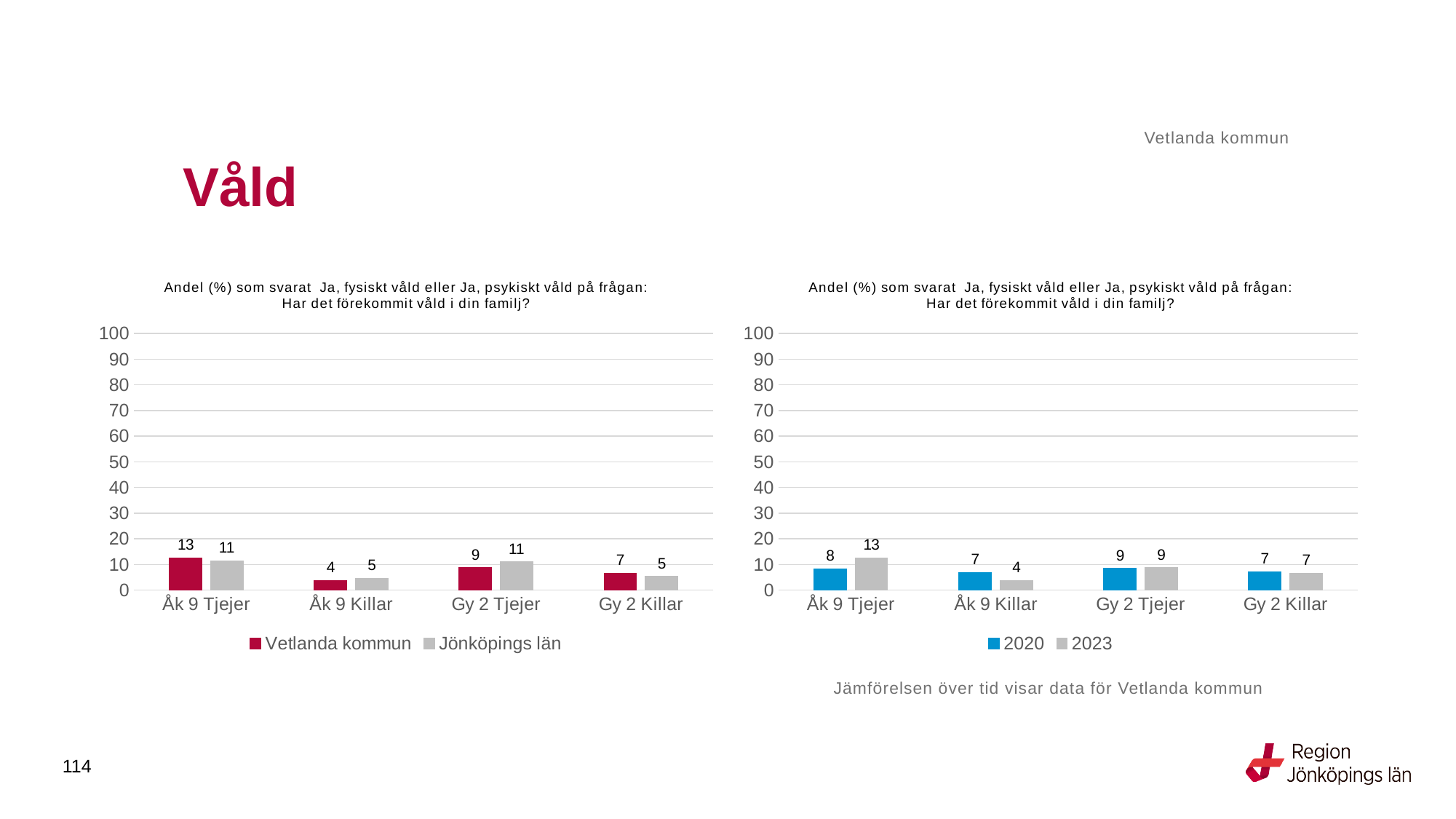
In the right chart, what is the value for 2023 for Åk 9 Killar? 4 In the right chart, how many categories are shown on the x axis? 4 In the left chart, which category has the highest value for Vetlanda kommun? Åk 9 Tjejer In the right chart, what is the difference between the 2023 and 2020 values for Åk 9 Tjejer? 5 What type of chart is the left chart? Bar chart In the right chart, which series is shown in blue? 2020 In the right chart, what is the value for 2020 for Gy 2 Tjejer? 9 In the left chart, which category has the lowest value for Jönköpings län? Åk 9 Killar In the left chart, what is the value for Jönköpings län for Gy 2 Killar? 5 In the left chart, which is larger for Gy 2 Tjejer: Vetlanda kommun or Jönköpings län? Jönköpings län In the right chart, how many series does the legend list? 2 In the left chart, what is the value for Vetlanda kommun for Åk 9 Tjejer? 13